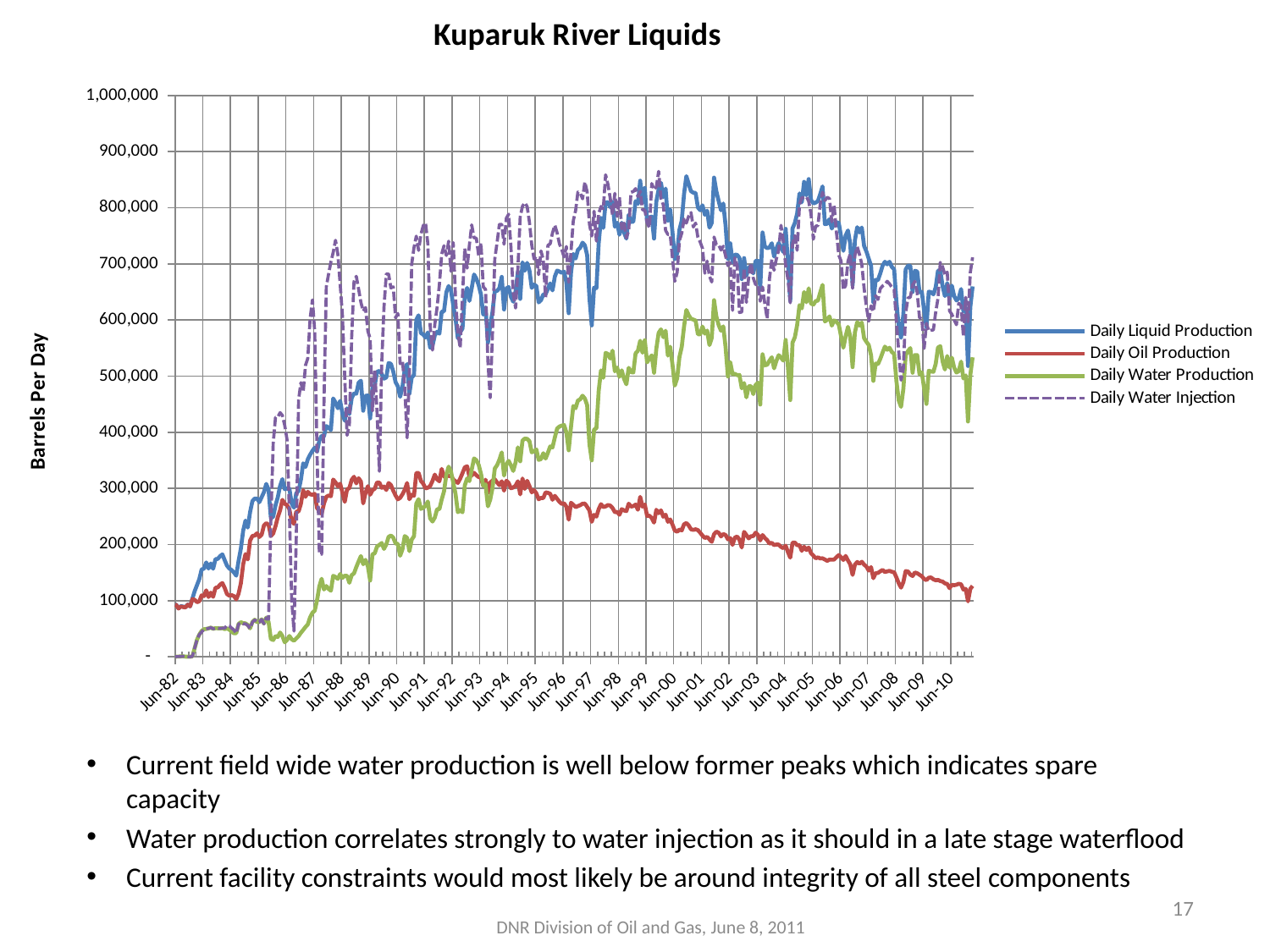
What kind of chart is shown on the slide? line chart Is the value for Daily Oil Production at Jun-10 greater or less than 200,000? less How many series does the legend list? 4 Does Daily Water Production rise or fall between Jun-86 and Jun-00? rise What is the label on the vertical axis? Barrels Per Day Is the value for Daily Liquid Production at Jun-05 greater or less than 700,000? greater At Jun-83, which is larger: Daily Oil Production or Daily Water Production? Daily Oil Production Does Daily Oil Production rise or fall between Jun-93 and Jun-10? fall At Jun-10, which is larger: Daily Water Production or Daily Oil Production? Daily Water Production Which series has the lowest value at Jun-10? Daily Oil Production Is the value for Daily Water Production at Jun-90 greater or less than 300,000? less What is the title of the chart? Kuparuk River Liquids